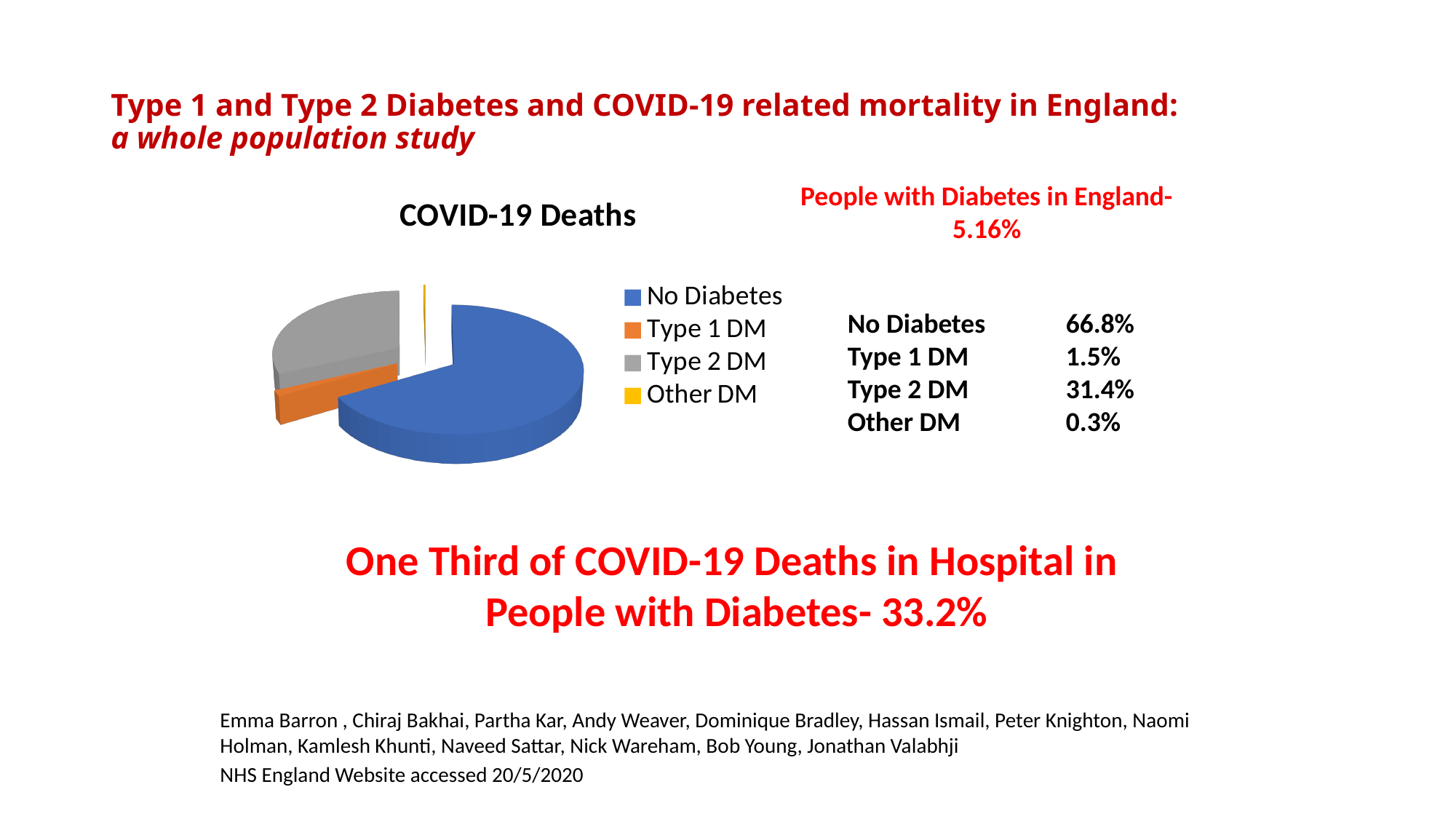
Which category has the largest slice of the COVID-19 Deaths pie chart? No Diabetes Which category has the smallest slice of the COVID-19 Deaths pie chart? Other DM What kind of chart is the COVID-19 Deaths chart? pie chart Which colour represents Type 2 DM in the pie chart legend? grey How many categories does the COVID-19 Deaths pie chart show? 4 What is the difference between the No Diabetes share and the Type 2 DM share of COVID-19 deaths? 35.4% What is the title of the pie chart? COVID-19 Deaths What share of COVID-19 deaths is attributed to No Diabetes? 66.8% Which is larger in the COVID-19 Deaths pie chart, Type 1 DM or Type 2 DM? Type 2 DM What share of COVID-19 deaths is attributed to Type 1 DM? 1.5% What share of COVID-19 deaths is attributed to Other DM? 0.3%